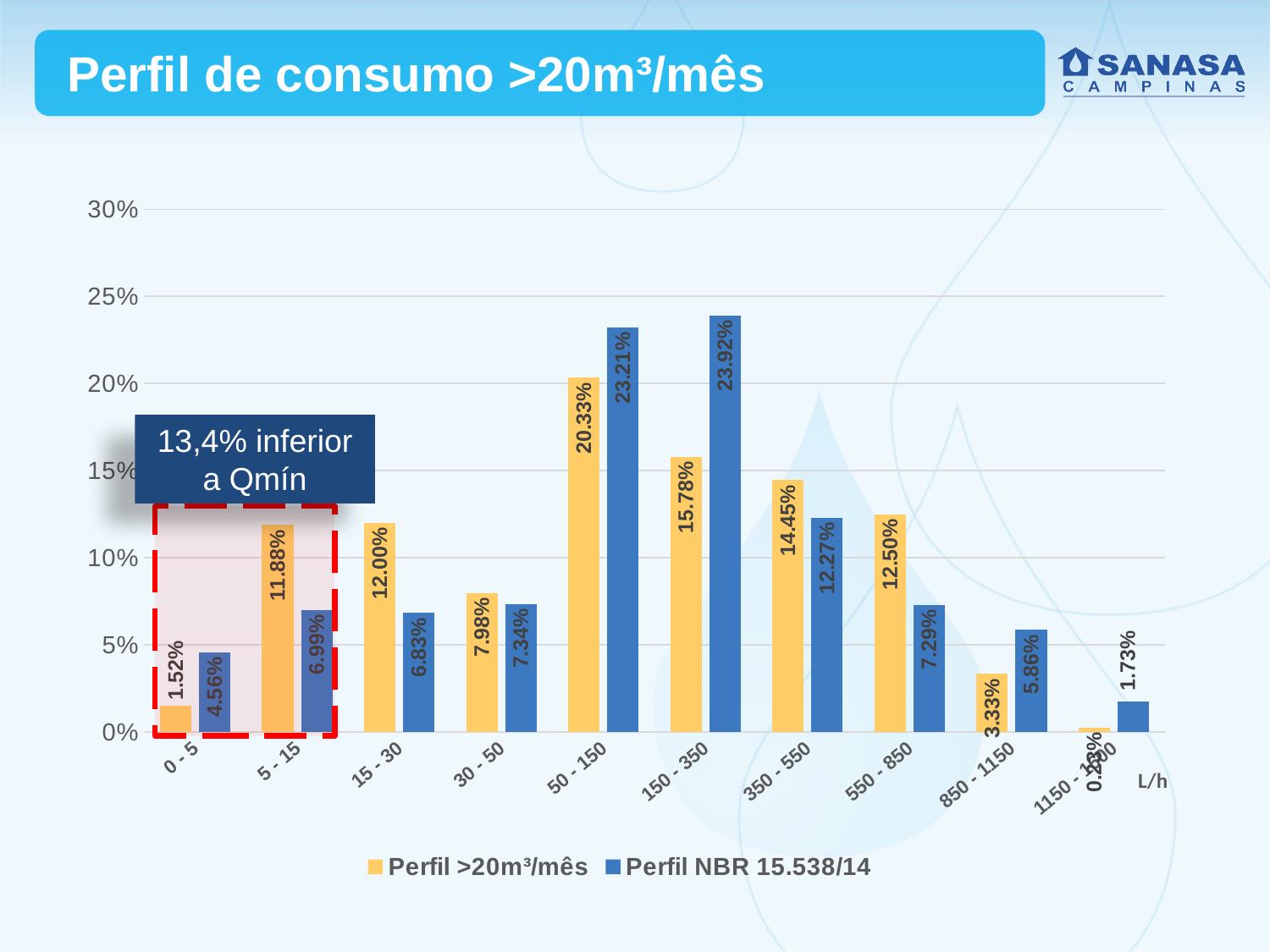
In the 5 - 15 category, which series has the larger value? Perfil >20m³/mês How many series does the legend list? 2 Which category has the highest value in the Perfil >20m³/mês series? 50 - 150 In the 0 - 5 category, how much higher is the Perfil NBR 15.538/14 value than the Perfil >20m³/mês value? 3.04 percentage points Is the Perfil NBR 15.538/14 value for the 50 - 150 category greater or less than 20%? greater Which category has the highest value in the Perfil NBR 15.538/14 series? 150 - 350 What text is shown in the dark callout box above the highlighted first two categories? 13,4% inferior a Qmín What is the value of the Perfil >20m³/mês series for the 550 - 850 category? 12.50% What is the value of the Perfil >20m³/mês series for the 50 - 150 category? 20.33% What kind of chart is shown on the slide? bar chart How many categories are shown on the x axis of the chart? 10 What is the value of the Perfil NBR 15.538/14 series for the 150 - 350 category? 23.92%